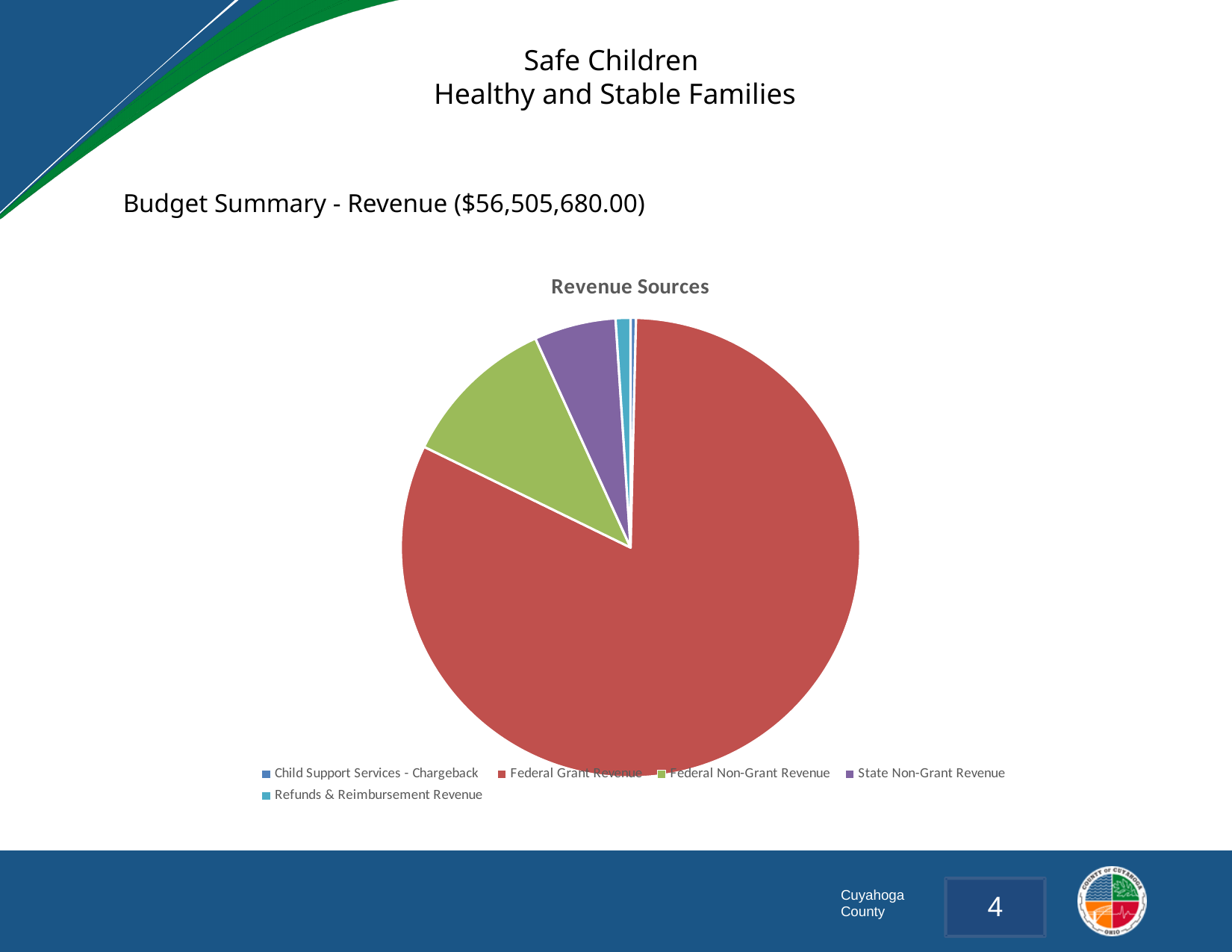
What kind of chart is shown on the slide? pie chart How many revenue source categories does the pie chart show? 5 Which is larger, the slice for Federal Non-Grant Revenue or the slice for State Non-Grant Revenue? Federal Non-Grant Revenue What is the title of the chart? Revenue Sources Which revenue source has the largest slice of the pie? Federal Grant Revenue Which revenue source is the second largest slice of the pie? Federal Non-Grant Revenue What colour is the slice for Federal Grant Revenue? red Which is larger, the slice for State Non-Grant Revenue or the slice for Refunds & Reimbursement Revenue? State Non-Grant Revenue Which is larger, the slice for Federal Grant Revenue or the slice for Federal Non-Grant Revenue? Federal Grant Revenue